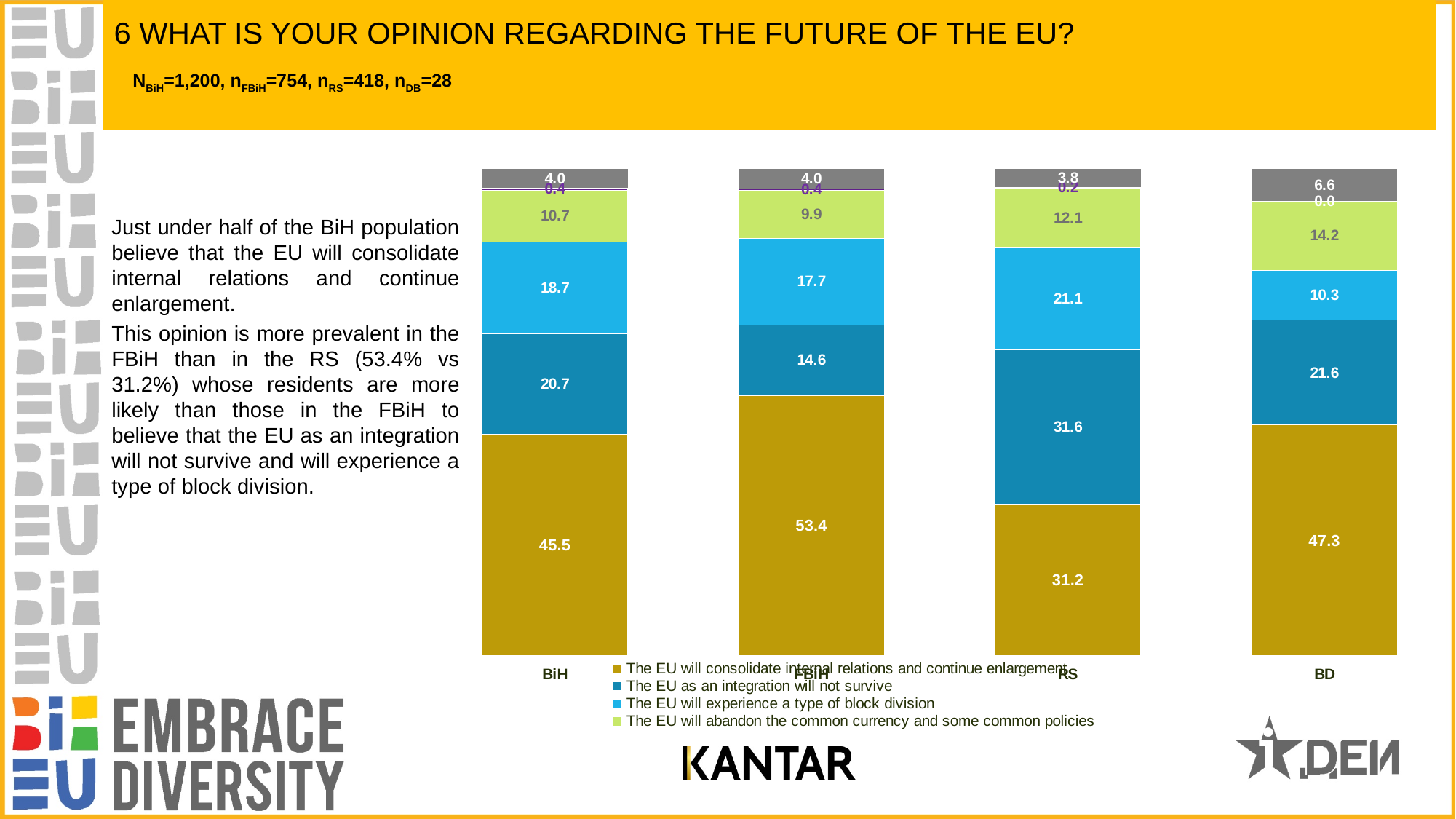
What is the value for 'The EU will experience a type of block division' in BD? 10.3 What is the value for 'The EU will abandon the common currency and some common policies' in BiH? 10.7 Which category has the highest value for 'The EU will consolidate internal relations and continue enlargement'? FBiH How many series does the chart legend list? 4 What kind of chart is shown on the slide? Stacked bar chart Which category has the lowest value for 'The EU will experience a type of block division'? BD What is the value for 'The EU as an integration will not survive' in RS? 31.6 What is the difference between the FBiH and RS values for 'The EU will consolidate internal relations and continue enlargement'? 22.2 Which colour represents 'The EU will abandon the common currency and some common policies' in the chart? Light green What percentage of respondents in FBiH believe the EU will consolidate internal relations and continue enlargement? 53.4 How many categories are shown on the x axis of the chart? 4 Which is larger in RS: 'The EU as an integration will not survive' or 'The EU will experience a type of block division'? The EU as an integration will not survive